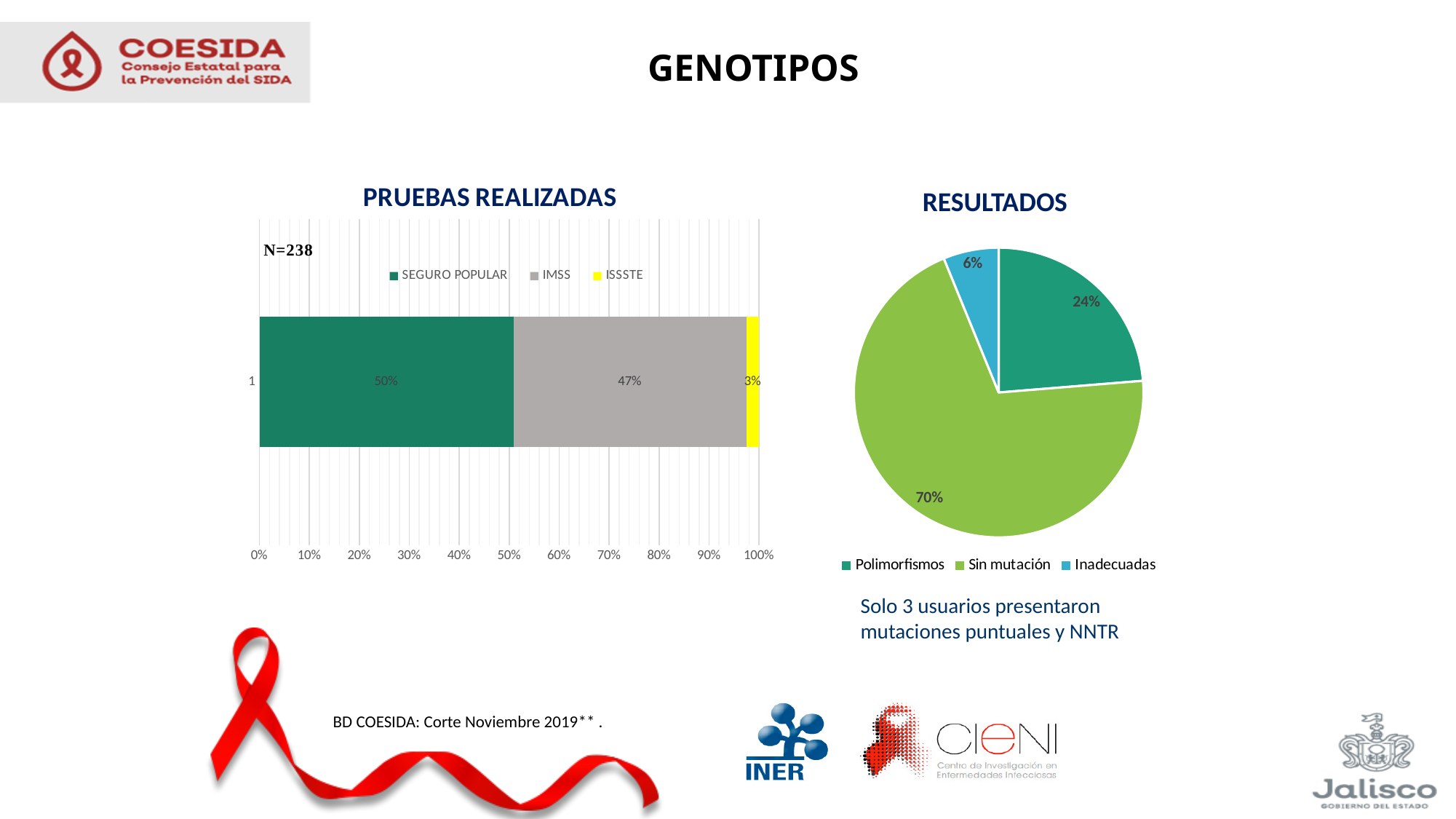
In the PRUEBAS REALIZADAS chart, what is the value for SEGURO POPULAR? 50% In the PRUEBAS REALIZADAS chart, what sample size (N) is shown? N=238 In the PRUEBAS REALIZADAS chart, how many series does the legend list? 3 What kind of chart is PRUEBAS REALIZADAS? Stacked bar chart In the PRUEBAS REALIZADAS chart, what is the value for IMSS? 47% In the RESULTADOS chart, what share does Sin mutación have? 70% In the PRUEBAS REALIZADAS chart, what is the difference between the SEGURO POPULAR and IMSS values? 3% In the RESULTADOS chart, which category has the smallest slice? Inadecuadas In the RESULTADOS chart, what share does Polimorfismos have? 24% In the PRUEBAS REALIZADAS chart, which series has the smallest share? ISSSTE In the PRUEBAS REALIZADAS chart, what is the value for ISSSTE? 3% In the RESULTADOS chart, what is the difference between the Sin mutación and Polimorfismos shares? 46%